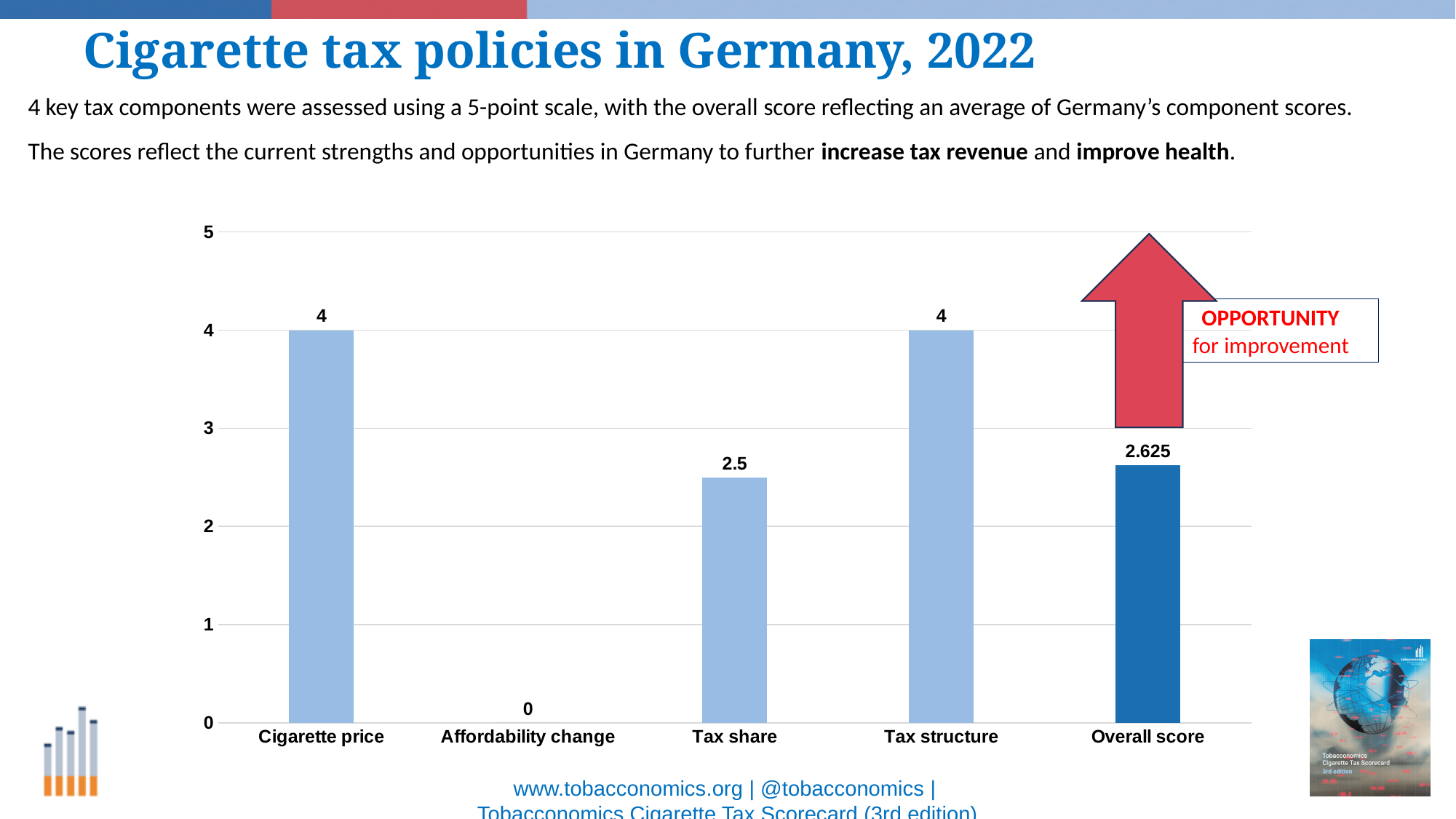
What kind of chart is shown on the slide? bar chart What is the value for Tax share? 2.5 What is the value for Overall score? 2.625 Which category has the lowest value? Affordability change How many categories are shown on the x axis? 5 What is the value for Cigarette price? 4 What is the maximum value shown on the y axis? 5 Which is larger, the value for Tax share or the value for Overall score? Overall score What is the value for Affordability change? 0 Which bar is shown in a darker blue than the others? Overall score Is the value for Tax share greater or less than 3? less What is the difference between the values for Tax structure and Tax share? 1.5